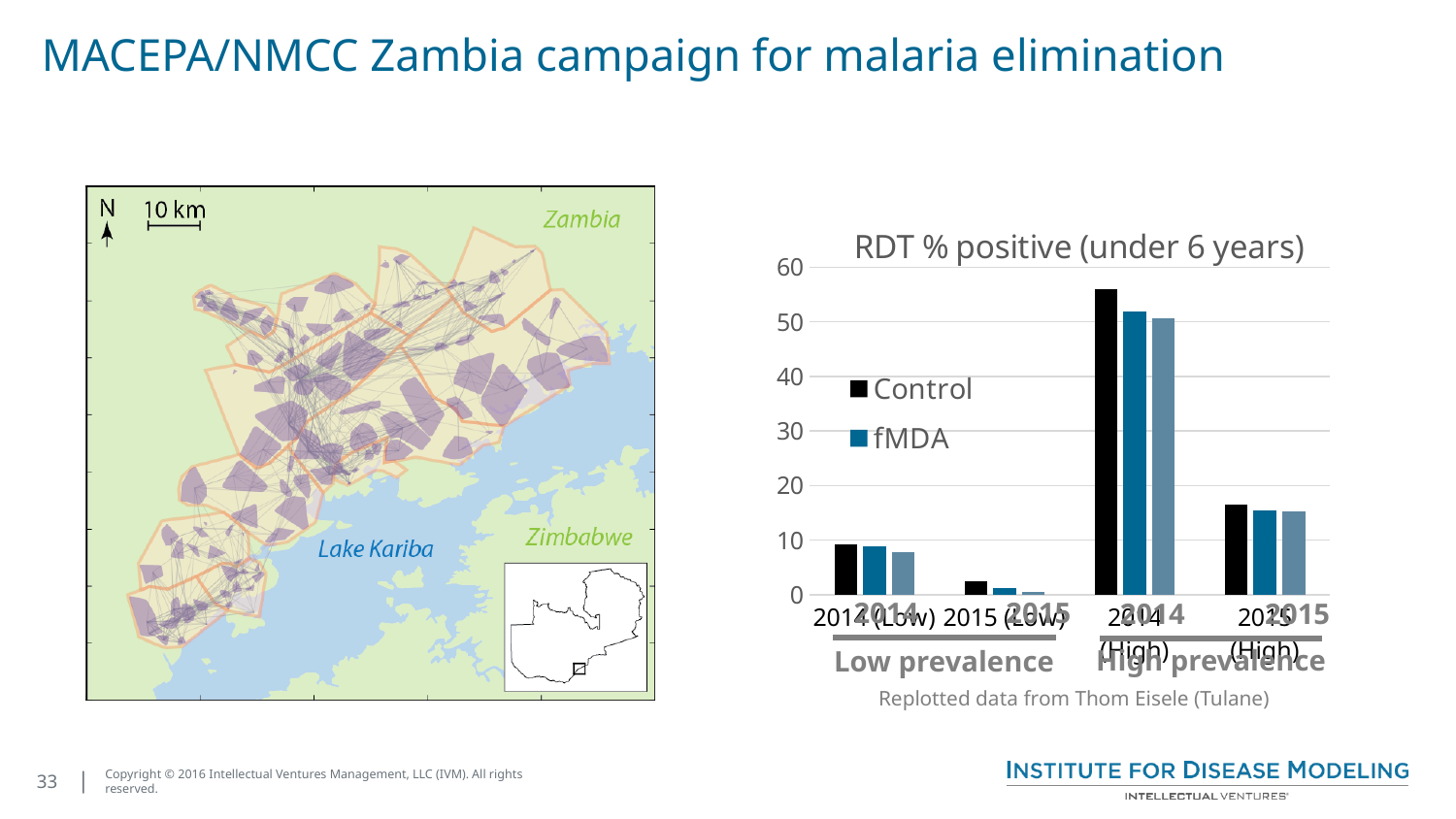
In the 'RDT % positive (under 6 years)' chart, is the fMDA value for 2015 (Low) greater or less than 10? less In the 'RDT % positive (under 6 years)' chart, which is larger: the Control value for 2014 (High) or the Control value for 2015 (High)? 2014 (High) In the 'RDT % positive (under 6 years)' chart, which category has the highest Control value? 2014 (High) In the 'RDT % positive (under 6 years)' chart, is the Control value for 2014 (High) greater or less than 50? greater How many categories are shown on the x axis of the 'RDT % positive (under 6 years)' chart? 4 In the 'RDT % positive (under 6 years)' chart, which category has the lowest Control value? 2015 (Low) In the 'RDT % positive (under 6 years)' chart, is the Control value for 2015 (High) greater or less than 10? greater How many series does the legend of the 'RDT % positive (under 6 years)' chart list? 2 What is the title of the chart on the right of the slide? RDT % positive (under 6 years) What kind of chart is the 'RDT % positive (under 6 years)' chart? bar chart In the 'RDT % positive (under 6 years)' chart, do the Control values rise or fall from 2014 (High) to 2015 (High)? fall